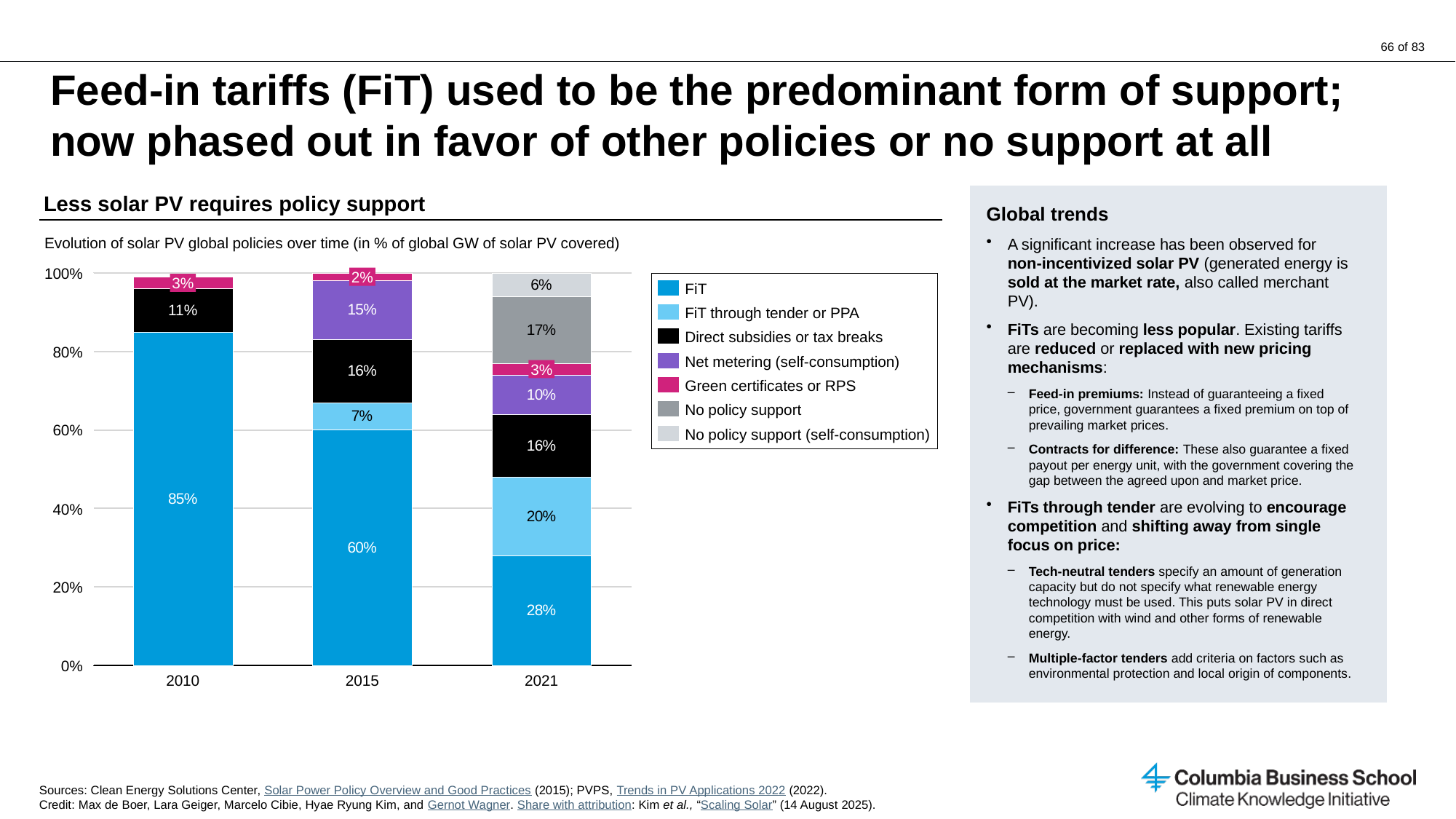
How many years are shown on the x axis of the chart? 3 What is the FiT share in 2010? 85% What kind of chart is shown on the slide? Stacked bar chart How many series does the chart's legend list? 7 What is the difference between the FiT share in 2010 and in 2021? 57% What is the share of Net metering (self-consumption) in 2015? 15% Does the FiT share rise or fall from 2010 to 2021? Fall In which year is the FiT share the highest? 2010 What is the share of FiT through tender or PPA in 2021? 20% Which is larger in 2021: the share of Direct subsidies or tax breaks or the share of Net metering (self-consumption)? Direct subsidies or tax breaks What is the share of No policy support in 2021? 17% In which year is the FiT share the lowest? 2021